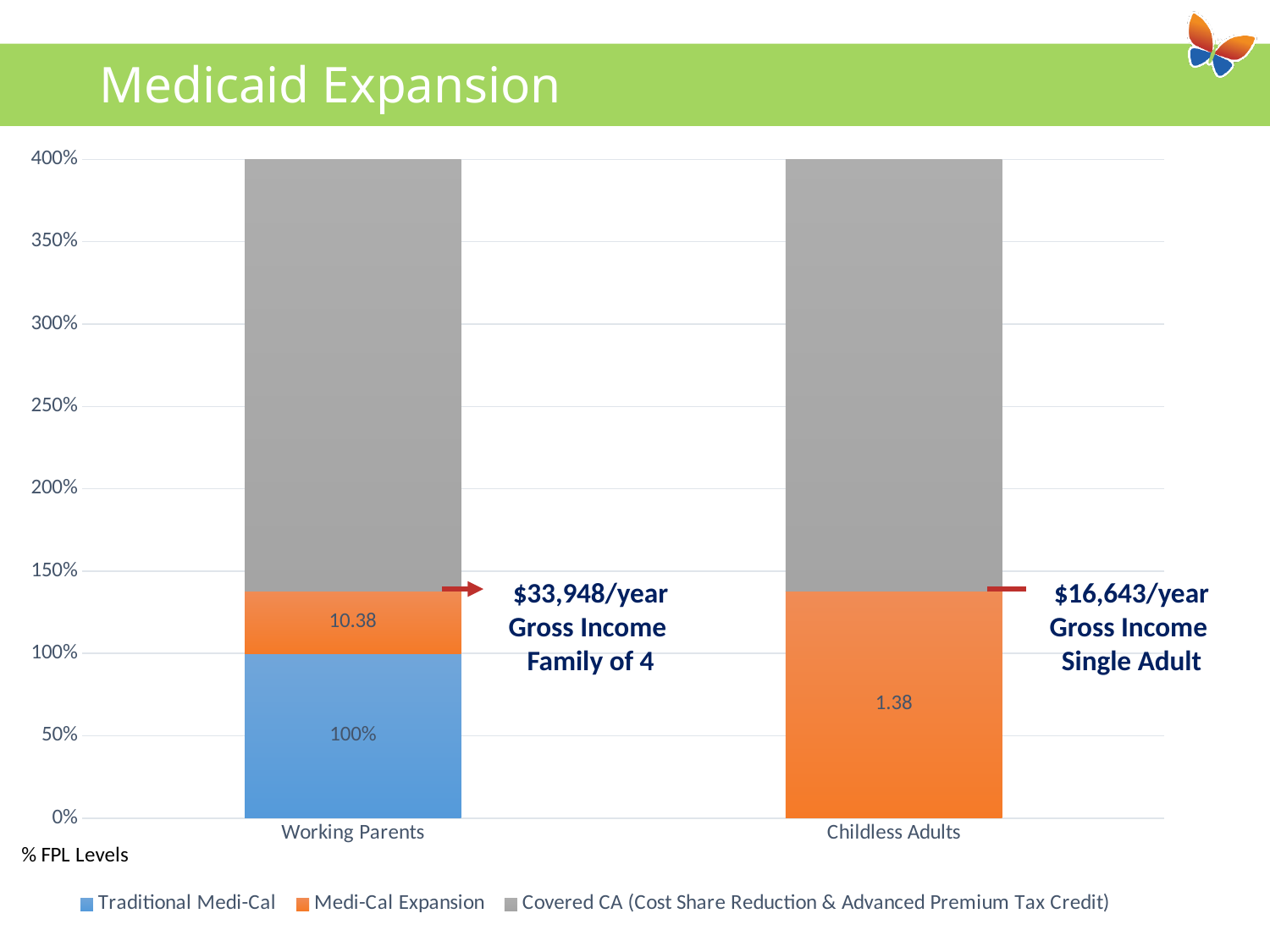
What is the data label on the Traditional Medi-Cal segment for Working Parents? 100% Is the top of the Medi-Cal Expansion segment for Childless Adults greater or less than 100% on the axis? greater What kind of chart is shown on the slide? Stacked bar chart What is the title of the slide containing the chart? Medicaid Expansion Which category has a Traditional Medi-Cal segment in its bar? Working Parents What annual gross income is annotated next to the Childless Adults bar? $16,643/year What is the data label on the Medi-Cal Expansion segment for Childless Adults? 1.38 How many series does the chart legend list? 3 How many categories are shown on the x axis of the chart? 2 What is the data label on the Medi-Cal Expansion segment for Working Parents? 10.38 Is the top of the full stacked bar for Working Parents greater or less than 350%? greater